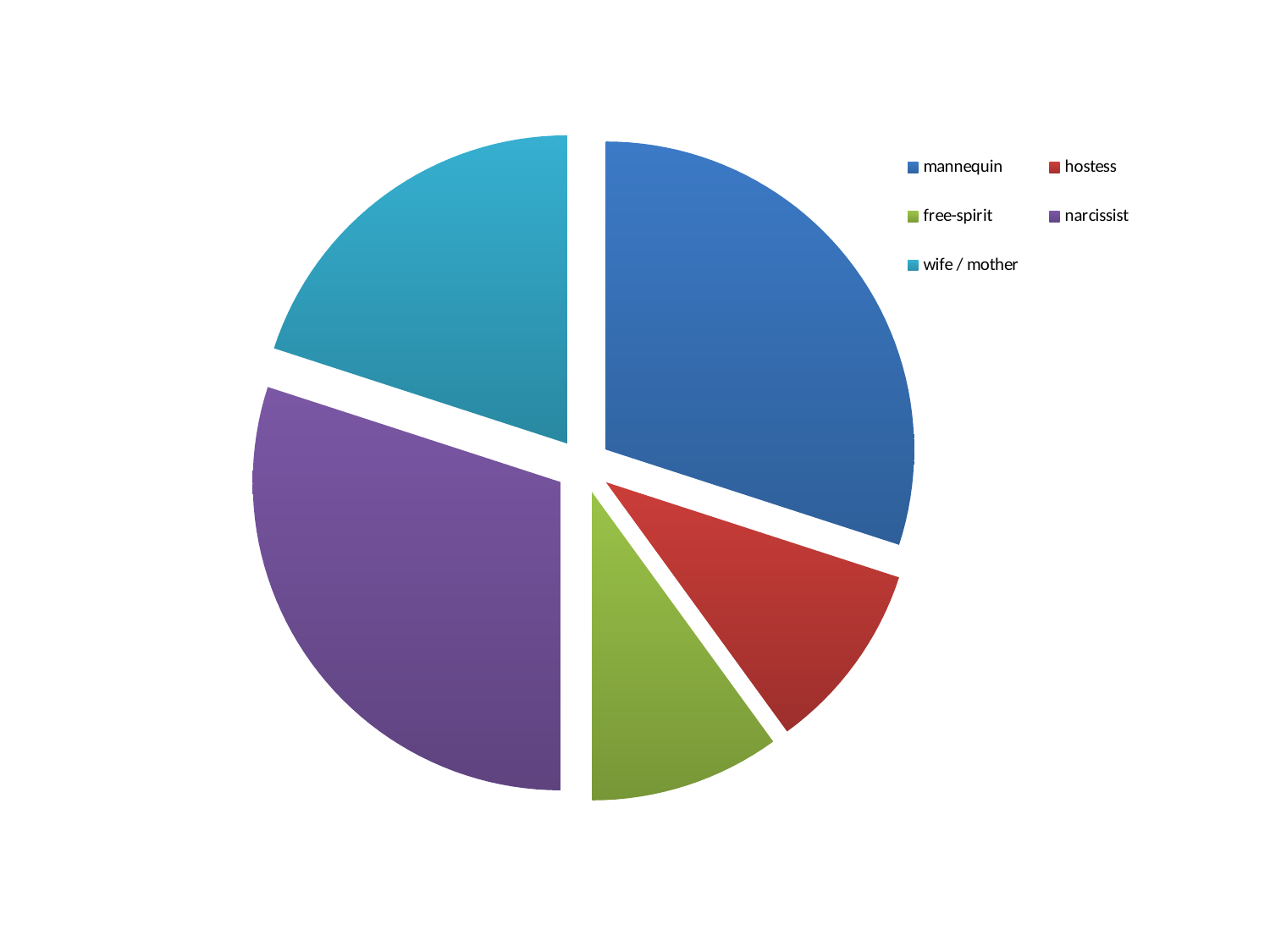
Which legend entry is shown in red? hostess Which slice is larger, wife / mother or free-spirit? wife / mother How many slices does the pie chart have? 5 Which slice is larger, mannequin or wife / mother? mannequin Which slice is larger, wife / mother or hostess? wife / mother What kind of chart is shown on the slide? pie chart What colour is the narcissist slice? purple How many entries does the legend list? 5